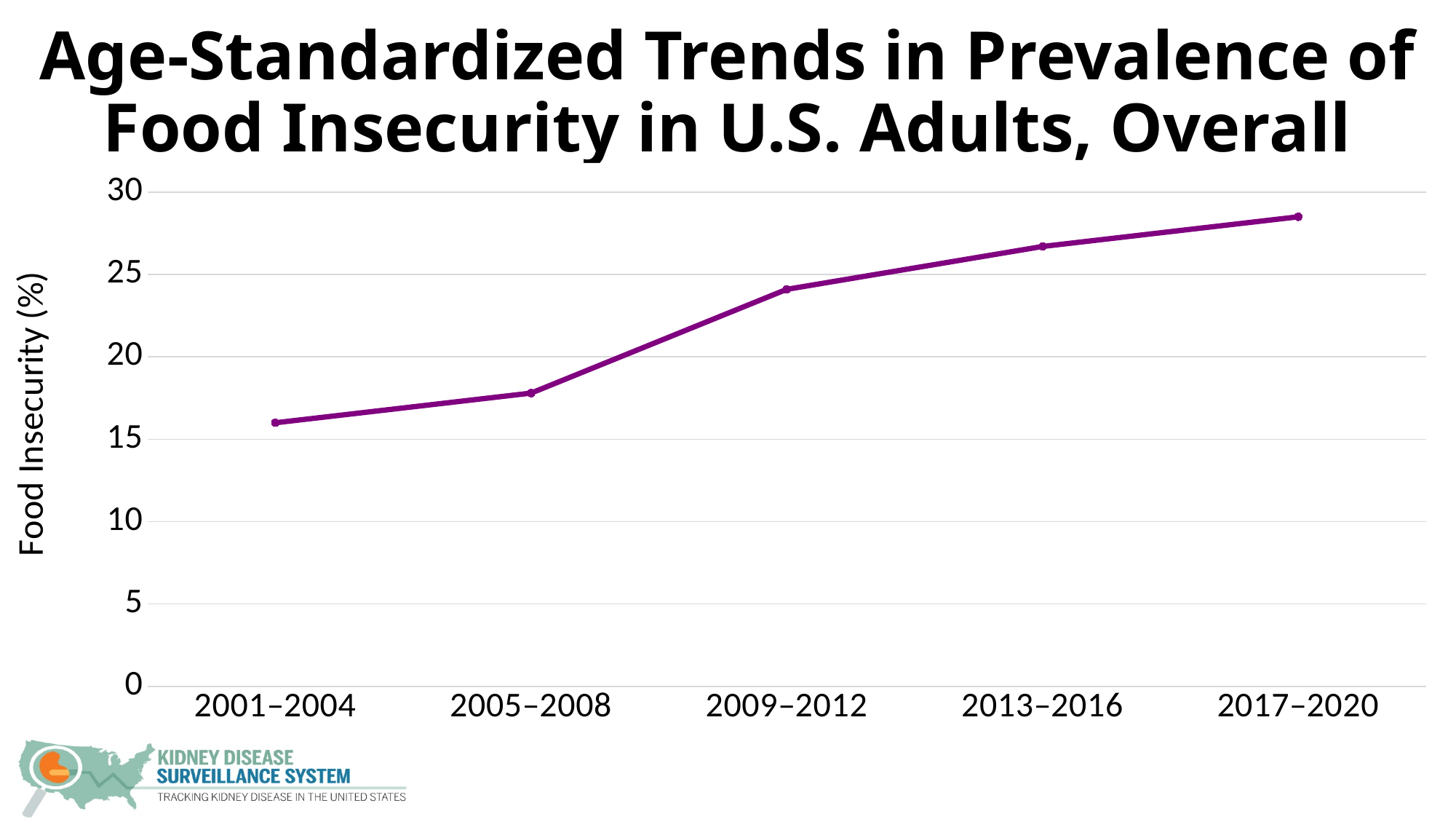
Is the value for 2001–2004 greater or less than 15? greater Is the value for 2009–2012 greater or less than 25? less Which is larger, the value for 2009–2012 or the value for 2005–2008? 2009–2012 How many time periods are plotted on the x axis? 5 Do the values rise or fall from 2001–2004 to 2017–2020? rise Which time period has the highest food insecurity prevalence? 2017–2020 Is the value for 2013–2016 greater or less than 25? greater Which time period has the lowest food insecurity prevalence? 2001–2004 What is the label on the y axis? Food Insecurity (%) What kind of chart is shown on the slide? line chart